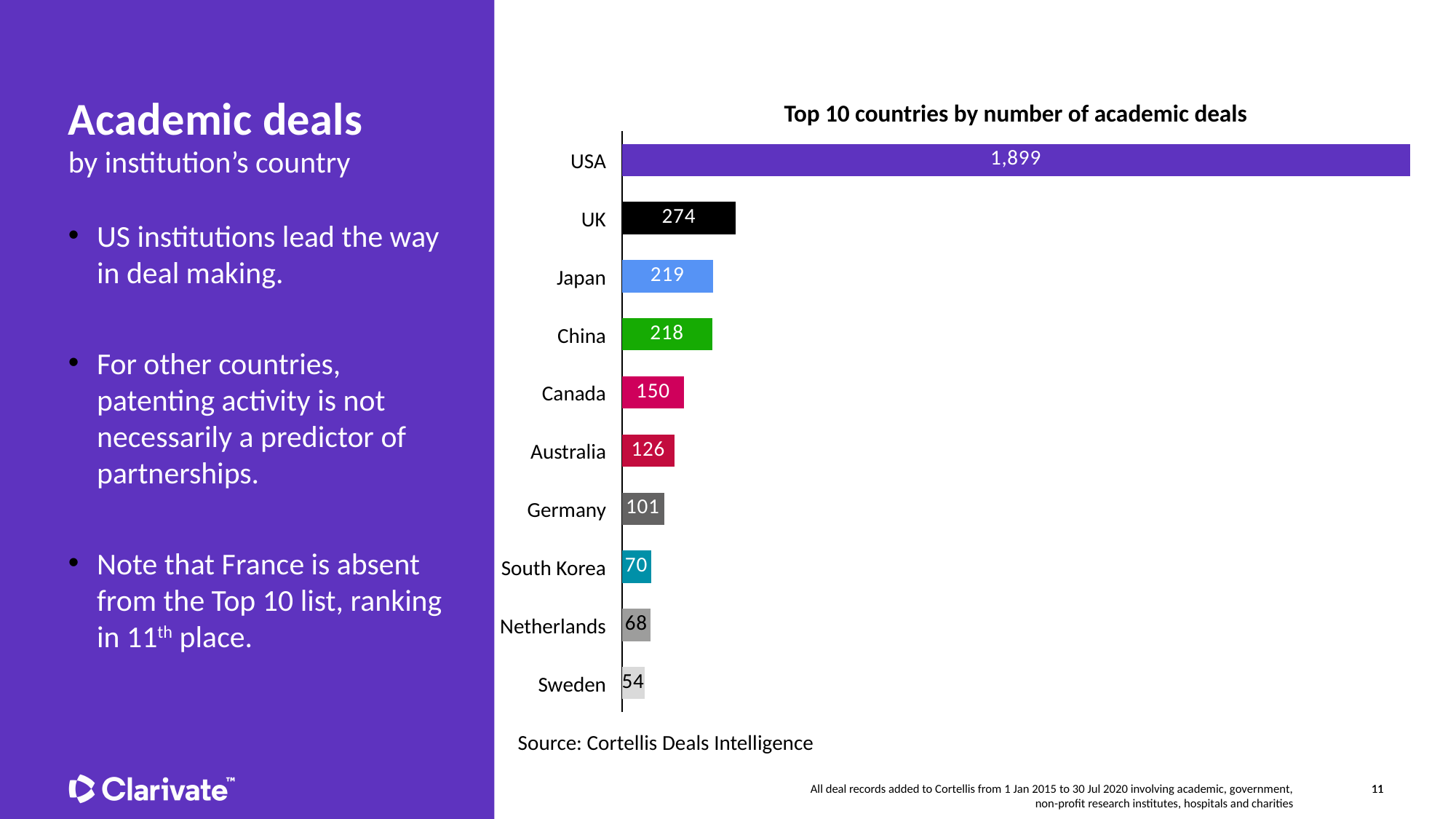
What is the source cited for the chart? Cortellis Deals Intelligence What type of chart is shown on the slide? Bar chart What is the difference in academic deals between the UK and Japan? 55 What is the number of academic deals for Canada? 150 Which country has the lowest number of academic deals? Sweden What is the title of the chart? Top 10 countries by number of academic deals What is the difference in academic deals between Germany and the Netherlands? 33 Which country has the highest number of academic deals? USA Which has more academic deals, Canada or Australia? Canada What is the number of academic deals for South Korea? 70 How many countries are shown in the chart? 10 What is the number of academic deals for the USA? 1,899